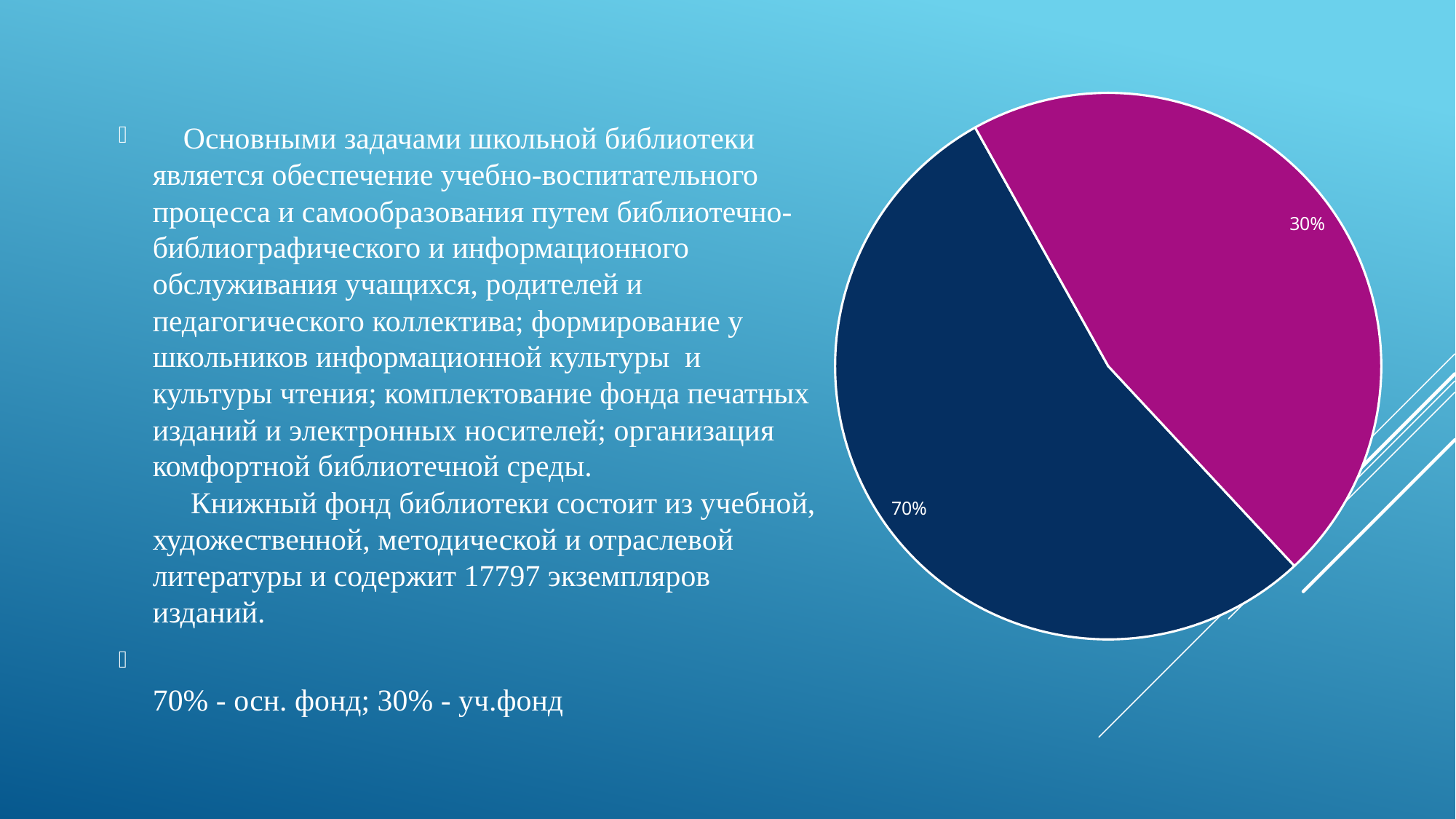
Which slice of the pie chart is the smallest? 30% (уч.фонд) Which slice of the pie chart is the largest? 70% (осн. фонд) According to the slide text, what share of the pie corresponds to осн. фонд? 70% According to the slide text, what share of the pie corresponds to уч.фонд? 30% Which is larger, the share for осн. фонд or the share for уч.фонд? осн. фонд What share of the pie does the dark blue slice represent? 70% How many slices does the pie chart have? 2 What share of the pie does the magenta slice represent? 30% What colour is the slice labelled 70%? dark blue What kind of chart is shown on the slide? pie chart What is the difference in percentage points between the two slices of the pie chart? 40 Is the share of the magenta slice greater or less than 50%? less